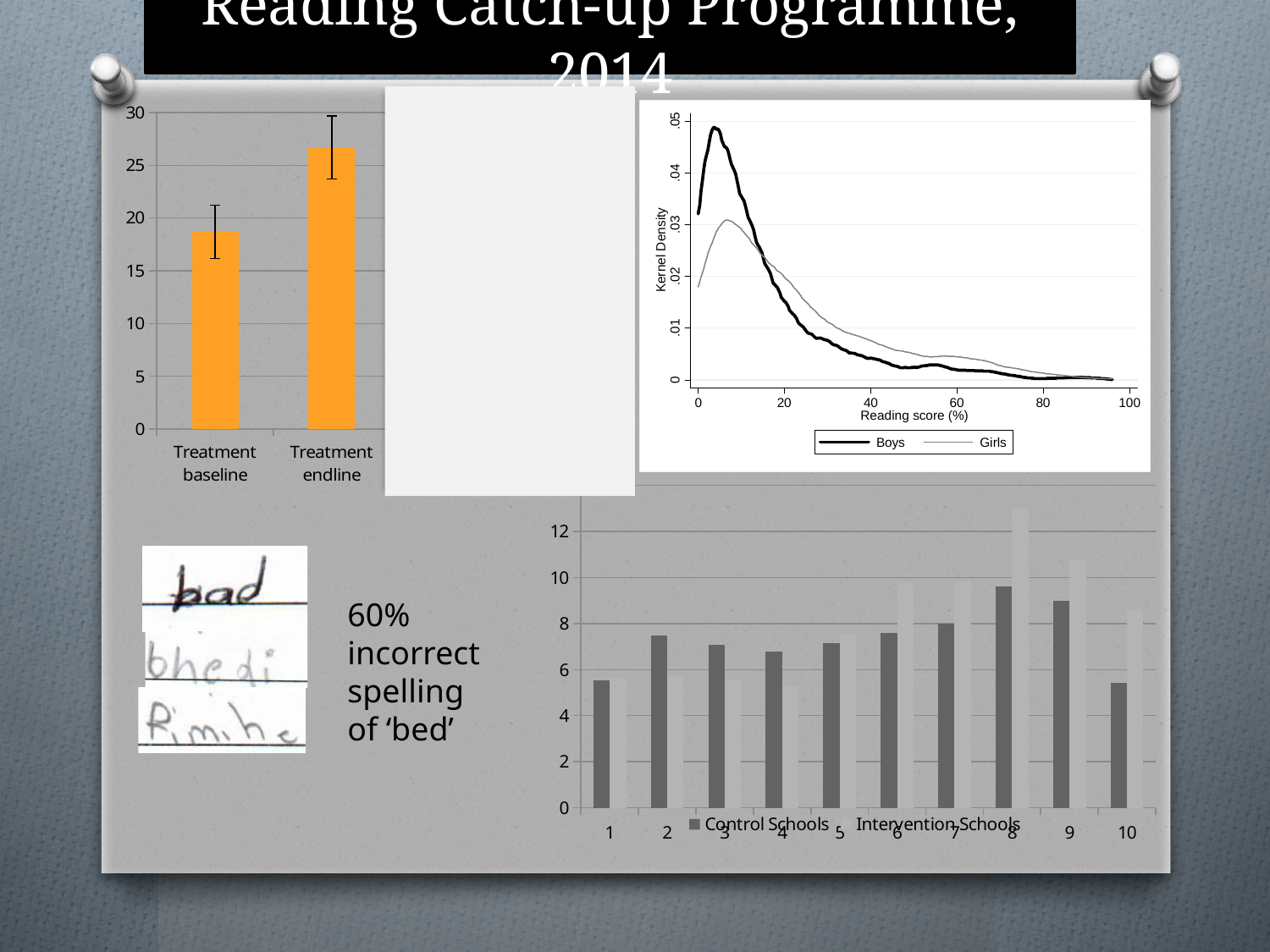
In the top-left bar chart, is the value for Treatment endline greater or less than 25? greater In the top-left bar chart, is the value for Treatment baseline greater or less than 15? greater What is the x-axis label of the top-right Kernel Density chart? Reading score (%) In the bottom bar chart, which series has the larger value for category 8, Control Schools or Intervention Schools? Intervention Schools In the top-left bar chart, which is larger, Treatment baseline or Treatment endline? Treatment endline What kind of chart is the top-right chart of Kernel Density against Reading score (%)? line chart How many categories are shown on the x axis of the bottom bar chart? 10 In the top-right Kernel Density chart, which series reaches the higher peak, Boys or Girls? Boys How many categories are shown in the top-left bar chart? 2 What kind of chart is the top-left chart with the Treatment baseline and Treatment endline bars? bar chart How many series does the legend of the top-right Kernel Density chart list? 2 In the bottom bar chart, is the Intervention Schools value for category 8 greater or less than 12? greater